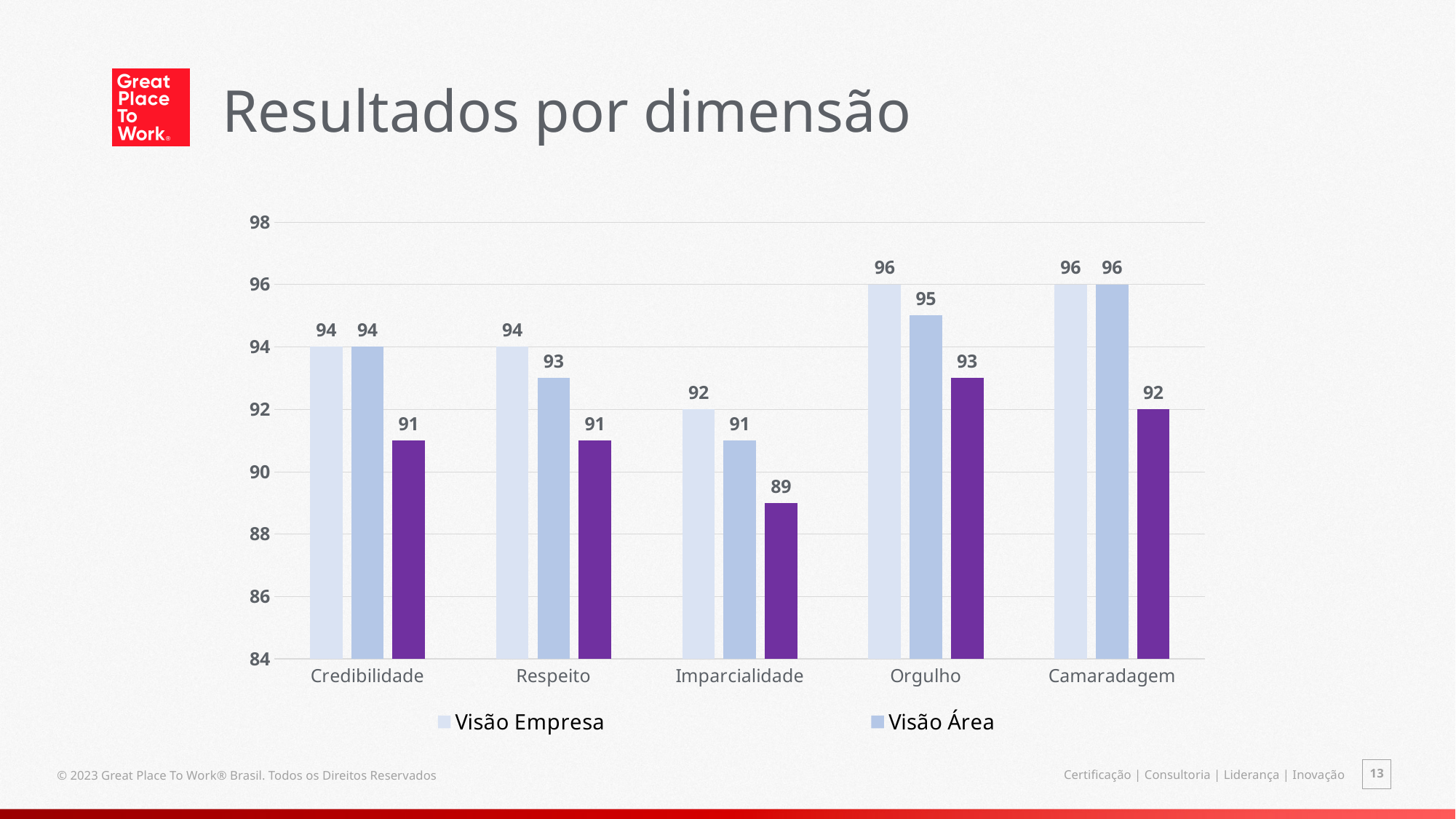
Which category has the lowest Visão Área value? Imparcialidade Which category has the lowest Visão Empresa value? Imparcialidade What is the difference between the Visão Empresa and Visão Área values for Orgulho? 1 Is the Visão Área value for Credibilidade greater or less than 90? greater How many series does the legend list? 2 For Respeito, which is larger: Visão Empresa or Visão Área? Visão Empresa What is the Visão Empresa value for Orgulho? 96 How many categories are shown on the x axis? 5 What is the value of the purple bar for Imparcialidade? 89 What is the title of the slide? Resultados por dimensão What is the Visão Área value for Respeito? 93 What is the Visão Área value for Imparcialidade? 91